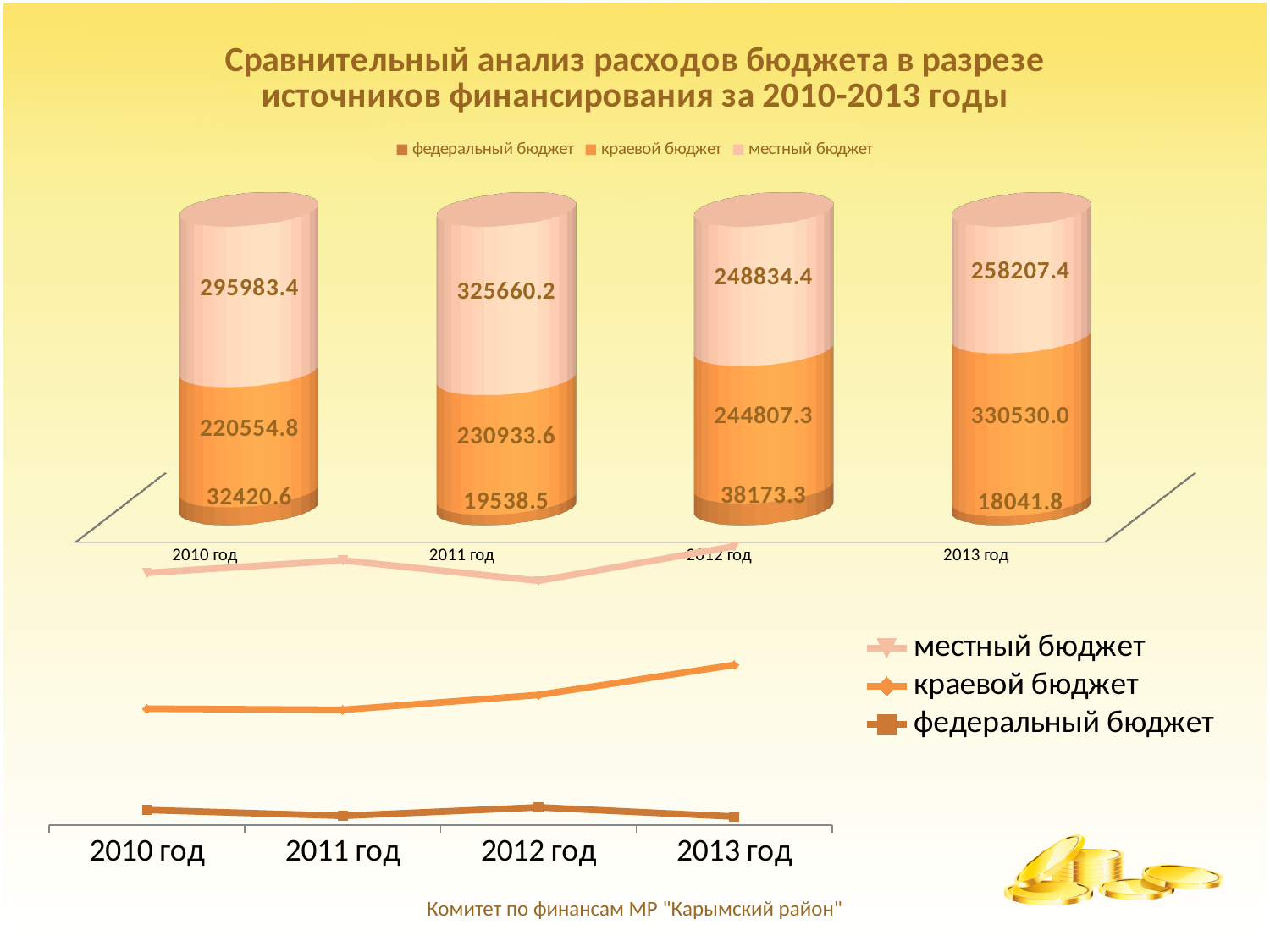
In the top stacked bar chart, which year has the lowest value for федеральный бюджет? 2013 год In the top stacked bar chart, which is larger in 2012 год: местный бюджет or краевой бюджет? местный бюджет How many series does the legend of the bottom line chart list? 3 What kind of chart is the bottom chart on the slide? line chart In the top stacked bar chart, what is the difference between the краевой бюджет values for 2013 год and 2012 год? 85722.7 In the top stacked bar chart, what is the value for краевой бюджет in 2013 год? 330530.0 In the top stacked bar chart, what is the value for федеральный бюджет in 2012 год? 38173.3 In the top stacked bar chart, what is the total of the stacked bar for 2010 год? 548958.8 In the bottom line chart, does the краевой бюджет line rise or fall from 2010 год to 2013 год? rise In the top stacked bar chart, which year has the highest value for краевой бюджет? 2013 год How many years are shown on the x axis of the top stacked bar chart? 4 In the top stacked bar chart, what is the value for местный бюджет in 2011 год? 325660.2